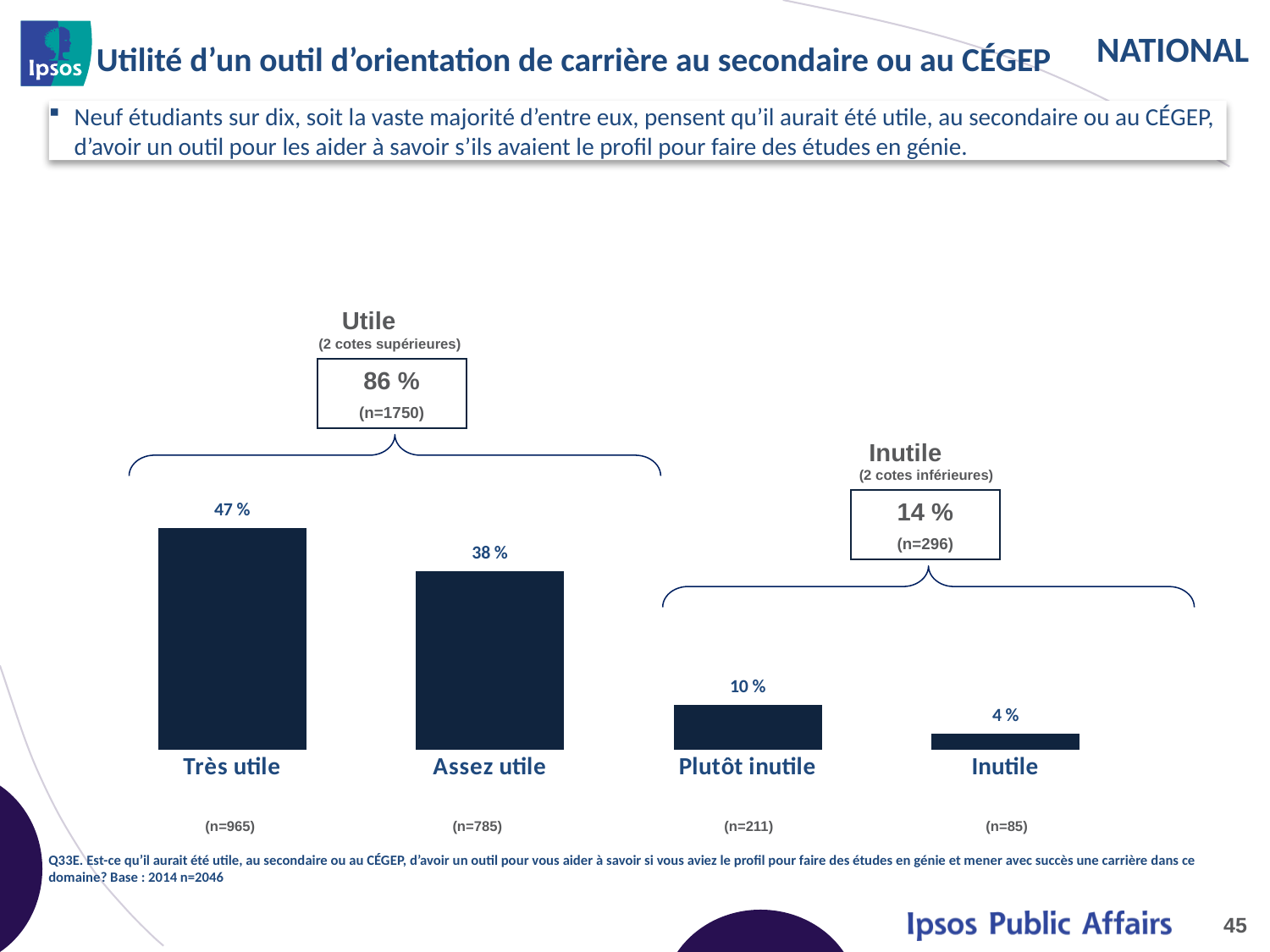
What is the difference in percentage points between "Très utile" and "Assez utile"? 9 What combined percentage is shown in the "Utile (2 cotes supérieures)" box? 86 % Which is larger, the percentage for "Plutôt inutile" or for "Inutile"? Plutôt inutile How many response categories are shown as bars in the chart? 4 What percentage of respondents answered "Assez utile"? 38 % Which response category has the highest percentage? Très utile What percentage of respondents answered "Très utile"? 47 % What percentage of respondents answered "Inutile"? 4 % Which response category has the lowest percentage? Inutile What kind of chart is shown on the slide? Bar chart What percentage of respondents answered "Plutôt inutile"? 10 % What is the sample size (n) shown for the "Très utile" category? n=965